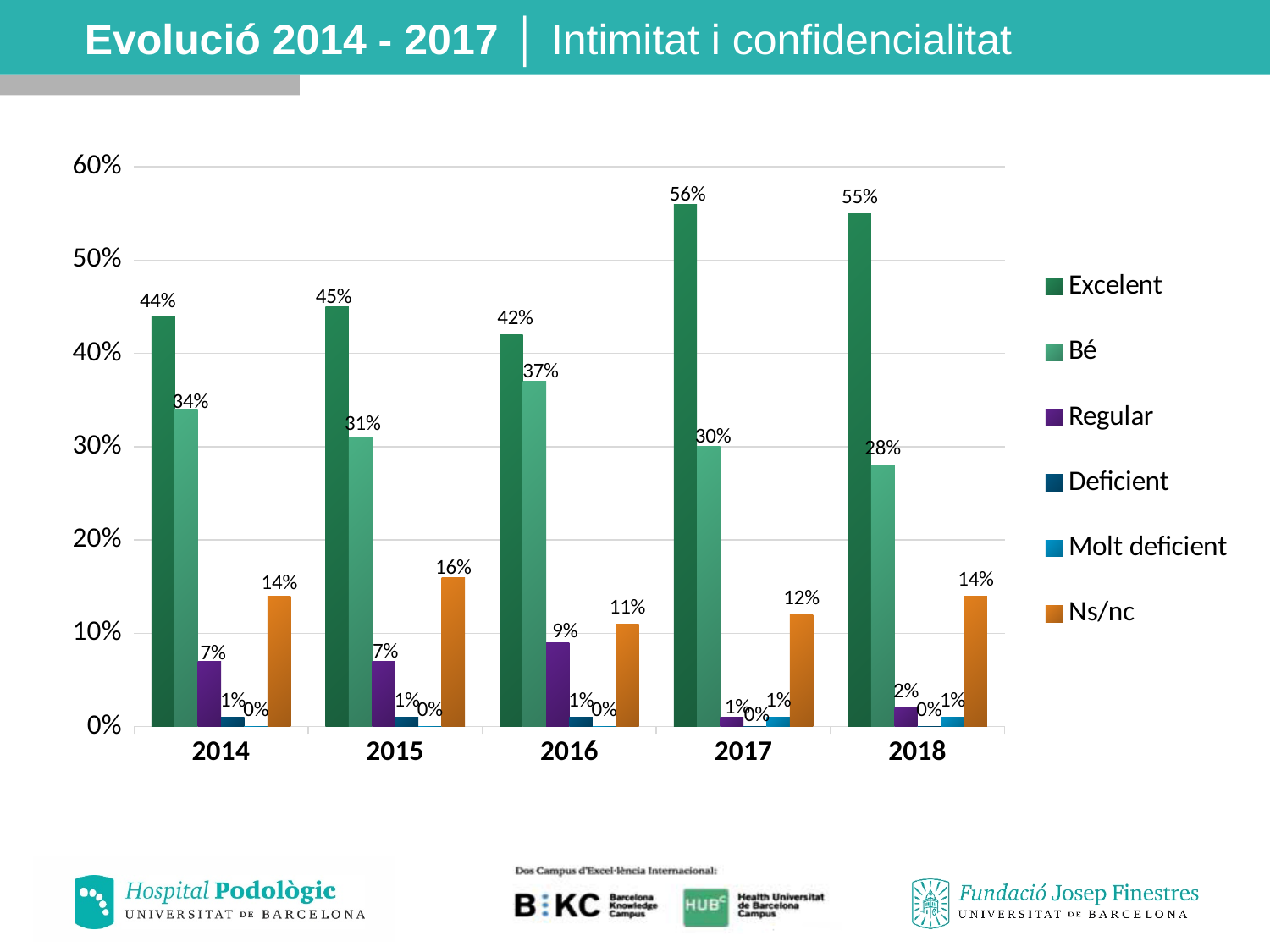
Which is larger, the Ns/nc value in 2016 or in 2018? 2018 What is the difference between the Excelent values for 2017 and 2014? 12% How many series does the legend list? 6 What is the value for Ns/nc in 2015? 16% What kind of chart is shown on the slide? Bar chart What is the value for Bé in 2014? 34% In which year is the Excelent value highest? 2017 In which year is the Bé value lowest? 2018 How many years are shown on the x axis? 5 Does the Bé value rise or fall from 2016 to 2018? Fall What is the value for Excelent in 2017? 56% What is the value for Regular in 2016? 9%